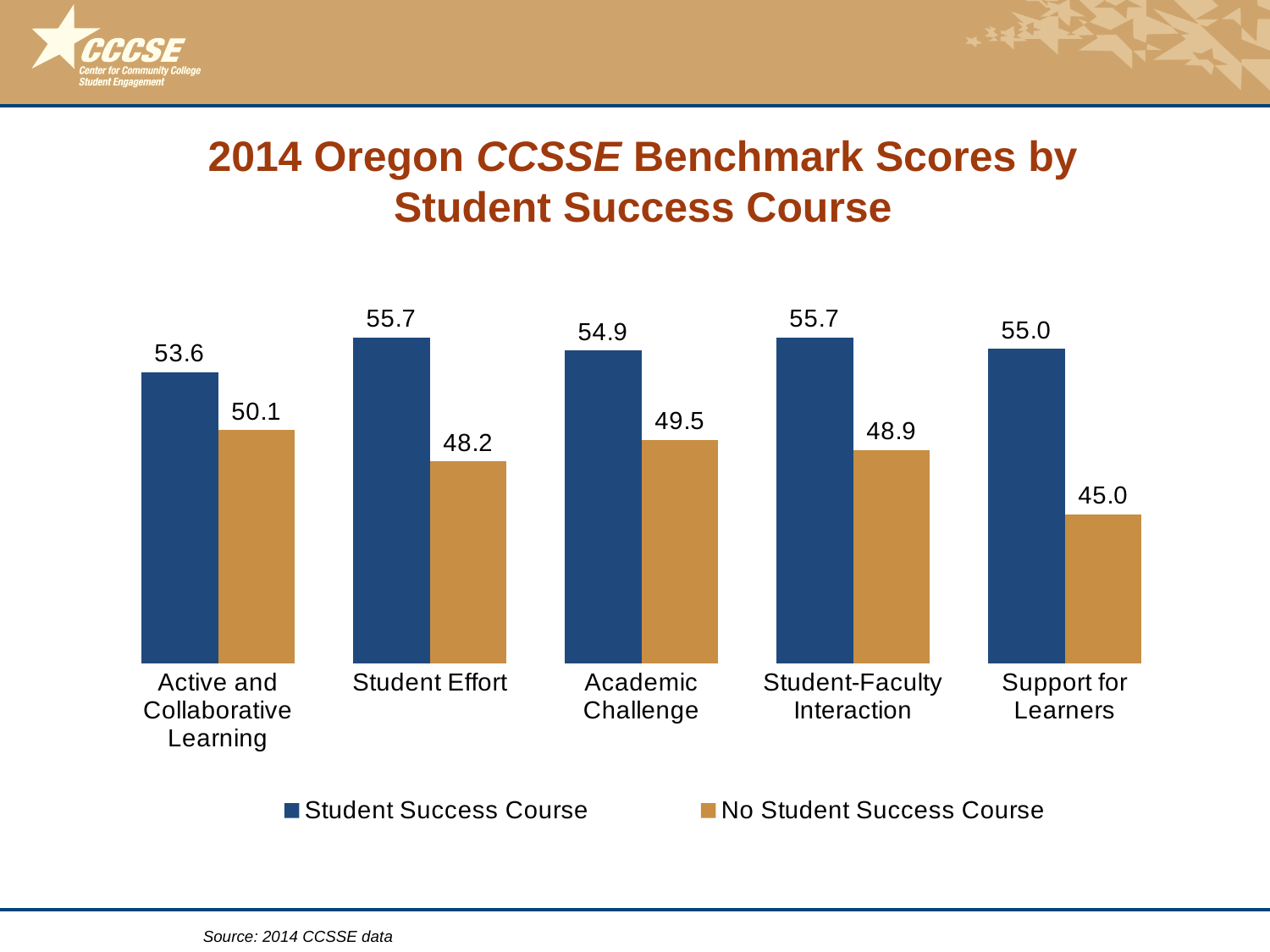
Which benchmark has the lowest Student Success Course score? Active and Collaborative Learning Which is larger: the No Student Success Course score for Active and Collaborative Learning or for Academic Challenge? Active and Collaborative Learning How many series does the legend list? 2 What is the Student Success Course score for Active and Collaborative Learning? 53.6 How many benchmark categories are shown on the chart? 5 What is the No Student Success Course score for Support for Learners? 45.0 What is the difference between the Student Success Course and No Student Success Course scores for Support for Learners? 10.0 What kind of chart is shown on the slide? Bar chart What is the difference between the Student Success Course and No Student Success Course scores for Academic Challenge? 5.4 Which series is shown in blue? Student Success Course Which benchmark has the lowest No Student Success Course score? Support for Learners What is the No Student Success Course score for Student Effort? 48.2